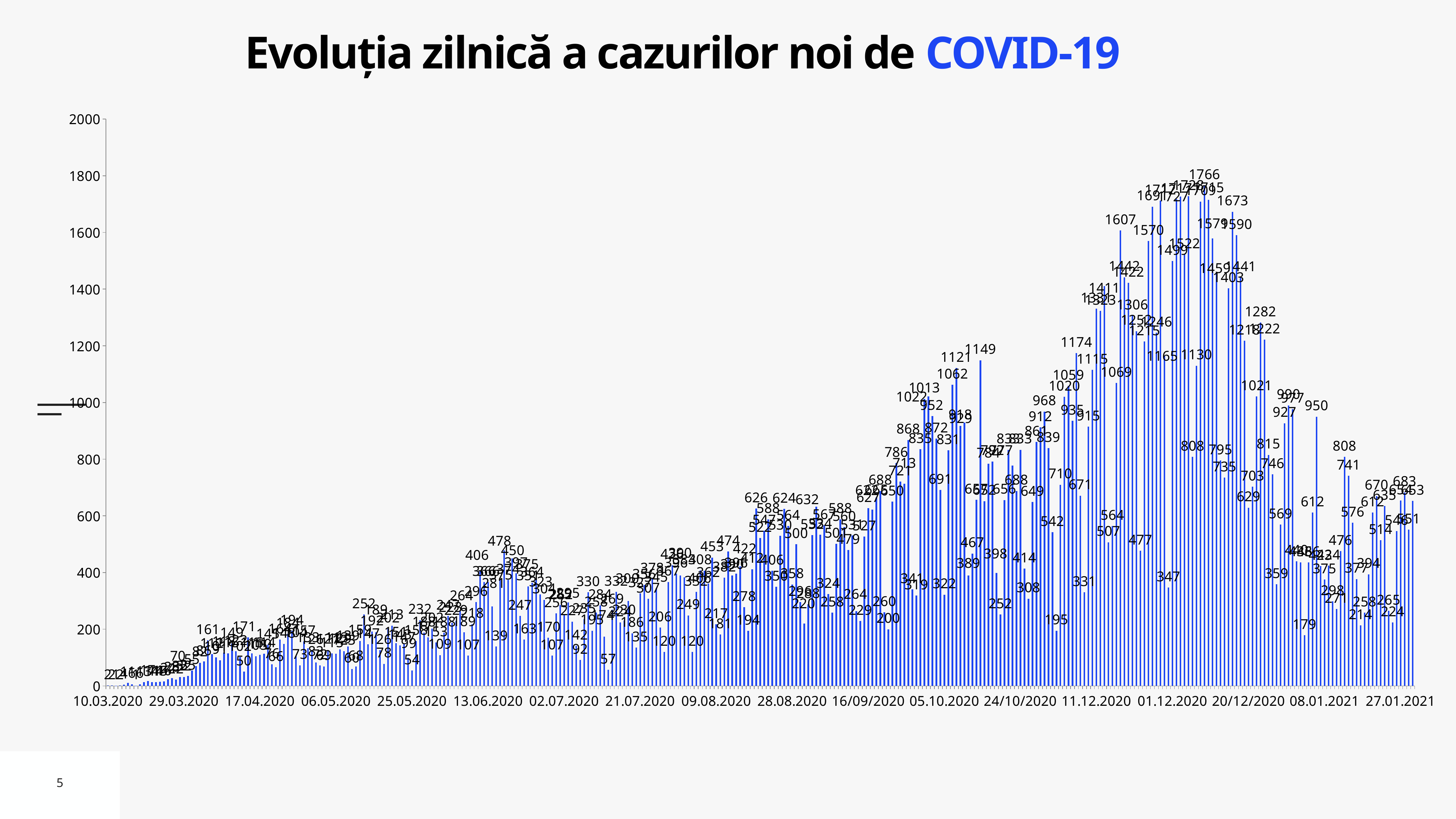
Overall, do the daily values rise or fall from March 2020 to December 2020? rise What kind of chart is shown on the slide? bar chart Which is larger: the value at 02.07.2020 or the value at 01.12.2020? 01.12.2020 Is the highest bar on the chart greater or less than 1600? greater What is the last date shown on the horizontal axis? 27.01.2021 What is the first date shown on the horizontal axis? 10.03.2020 What is the title of the chart? Evoluția zilnică a cazurilor noi de COVID-19 Is the value for the bar at 02.07.2020 greater or less than 600? less Is the value for the last bar, at 27.01.2021, greater or less than 800? less What is the highest daily value labeled on the chart? 1766 What is the difference between the highest data label, 1766, and the 1673 label just to its right? 93 What is the maximum value shown on the vertical axis? 2000